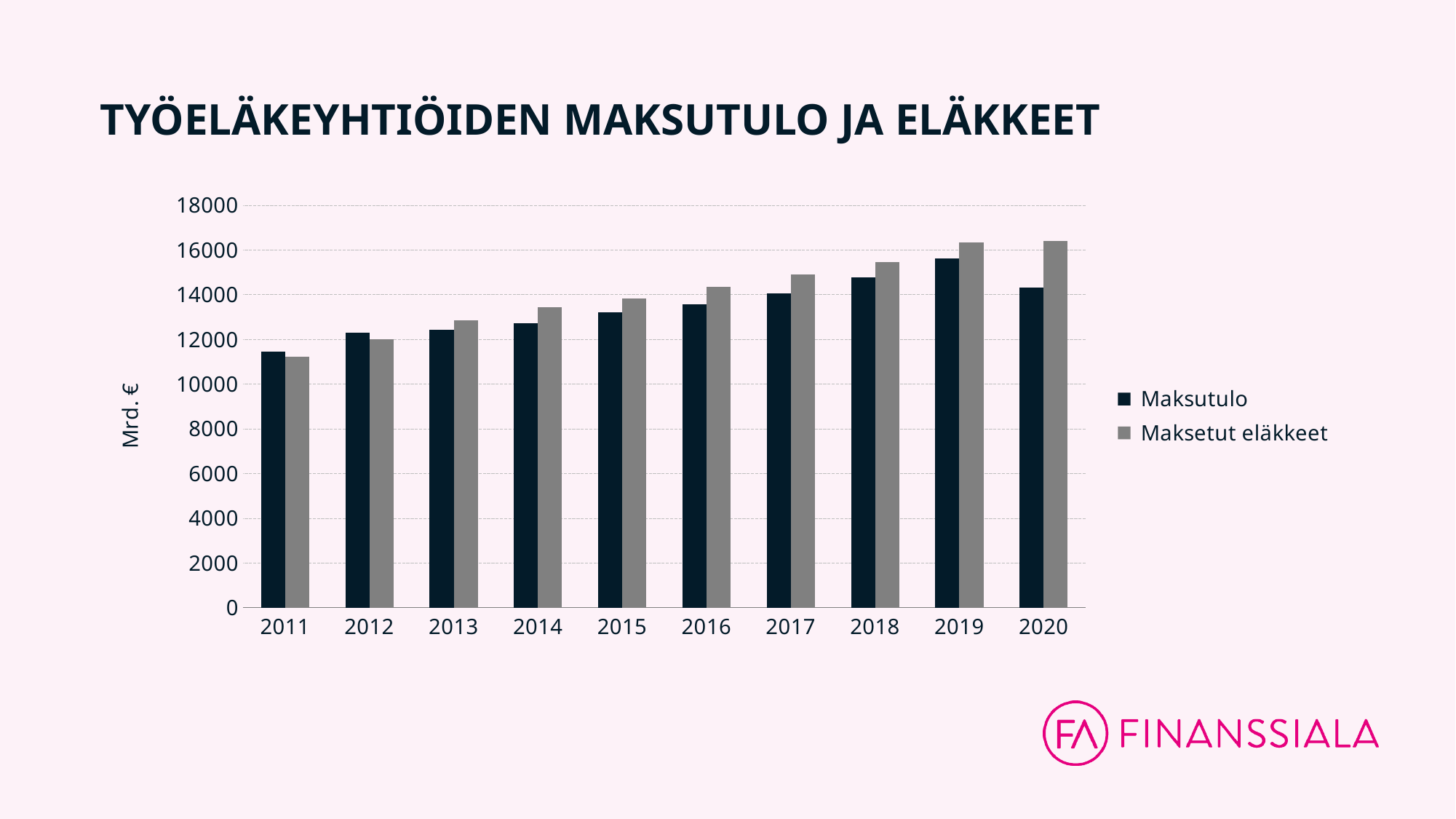
In which year is Maksutulo lowest? 2011 In which year is Maksetut eläkkeet lowest? 2011 What kind of chart is shown on the slide? bar chart What is the label on the y axis? Mrd. € How many series does the legend list? 2 In which year is Maksutulo highest? 2019 In 2012, which is larger, Maksutulo or Maksetut eläkkeet? Maksutulo Is the value for Maksetut eläkkeet in 2020 greater or less than 16000? greater Is the value for Maksutulo in 2011 greater or less than 10000? greater Is the value for Maksutulo in 2016 greater or less than 14000? less How many years are shown on the x axis? 10 In 2020, which is larger, Maksutulo or Maksetut eläkkeet? Maksetut eläkkeet